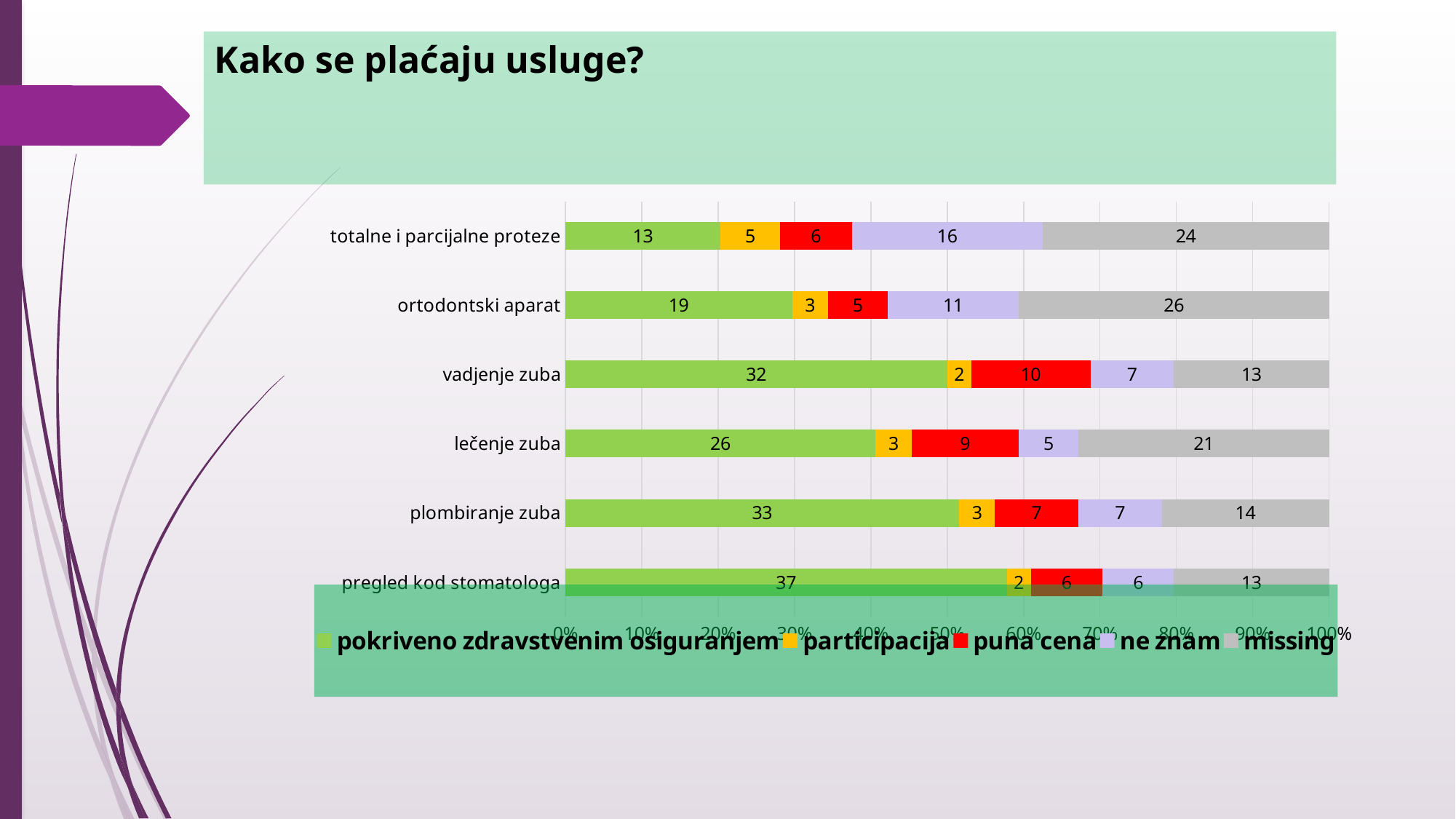
What is the value of 'pokriveno zdravstvenim osiguranjem' for 'pregled kod stomatologa'? 37 Which category has the highest value for 'pokriveno zdravstvenim osiguranjem'? pregled kod stomatologa Which category has the lowest value for 'pokriveno zdravstvenim osiguranjem'? totalne i parcijalne proteze Which is larger: the 'puna cena' value for 'lečenje zuba' or for 'plombiranje zuba'? lečenje zuba What is the value of 'puna cena' for 'vadjenje zuba'? 10 What is the value of 'missing' for 'ortodontski aparat'? 26 How many series does the legend list? 5 How many categories are shown on the chart? 6 What is the total of all segments in the bar for 'lečenje zuba'? 64 What type of chart is shown on the slide? stacked bar chart What is the difference between the 'missing' values for 'ortodontski aparat' and 'vadjenje zuba'? 13 What is the value of 'ne znam' for 'totalne i parcijalne proteze'? 16